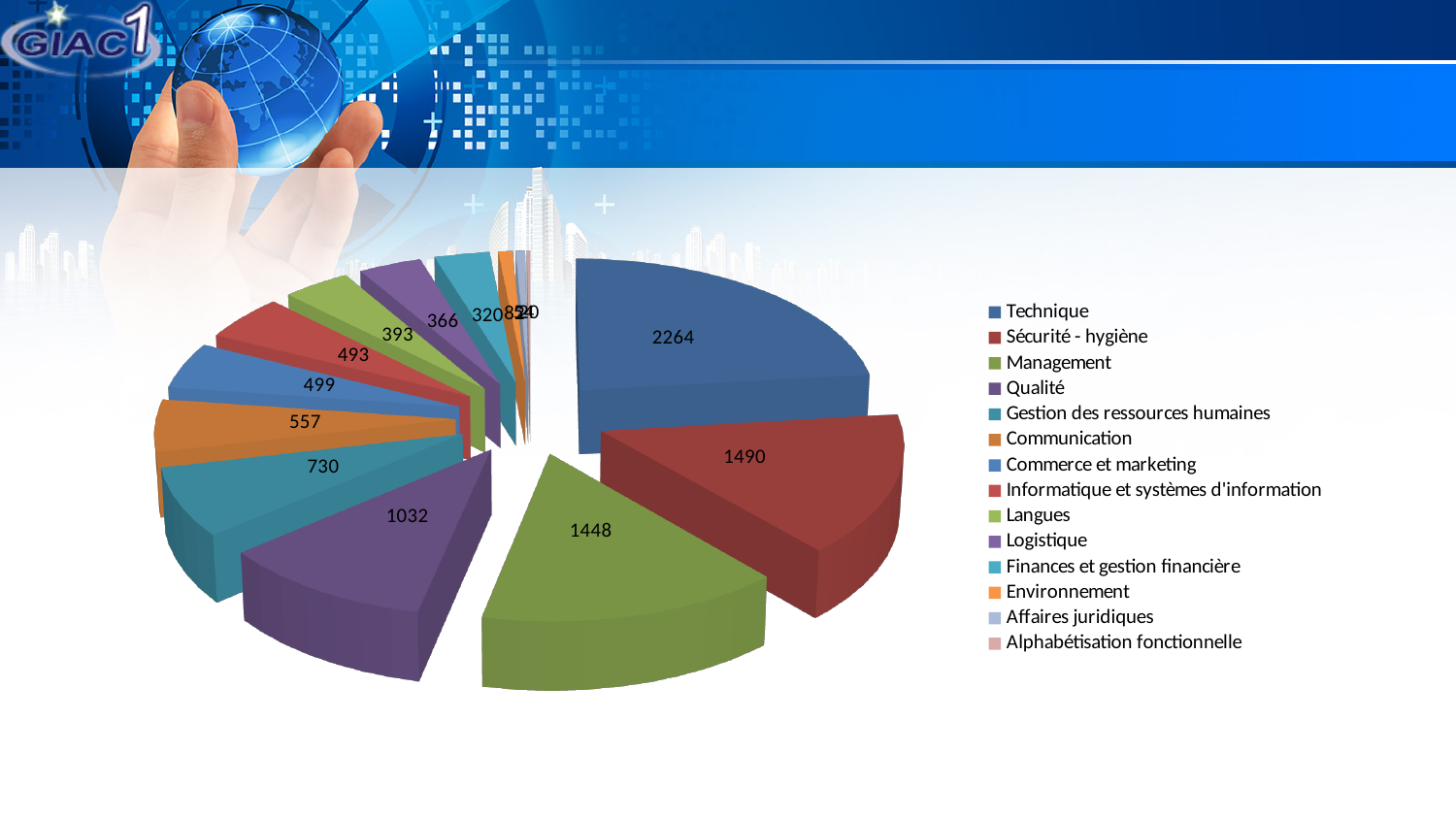
What is the value shown for Management? 1448 What is the value shown for Gestion des ressources humaines? 730 What colour is the slice for Technique? blue What is the difference between the values for Technique and Sécurité - hygiène? 774 Which is larger, the value for Management or the value for Qualité? Management What is the value shown for Technique? 2264 Which category has the largest slice of the pie? Technique What is the value shown for Qualité? 1032 What is the value shown for Communication? 557 What kind of chart is shown on the slide? pie chart What is the value shown for Sécurité - hygiène? 1490 How many categories does the legend of the pie chart list? 14